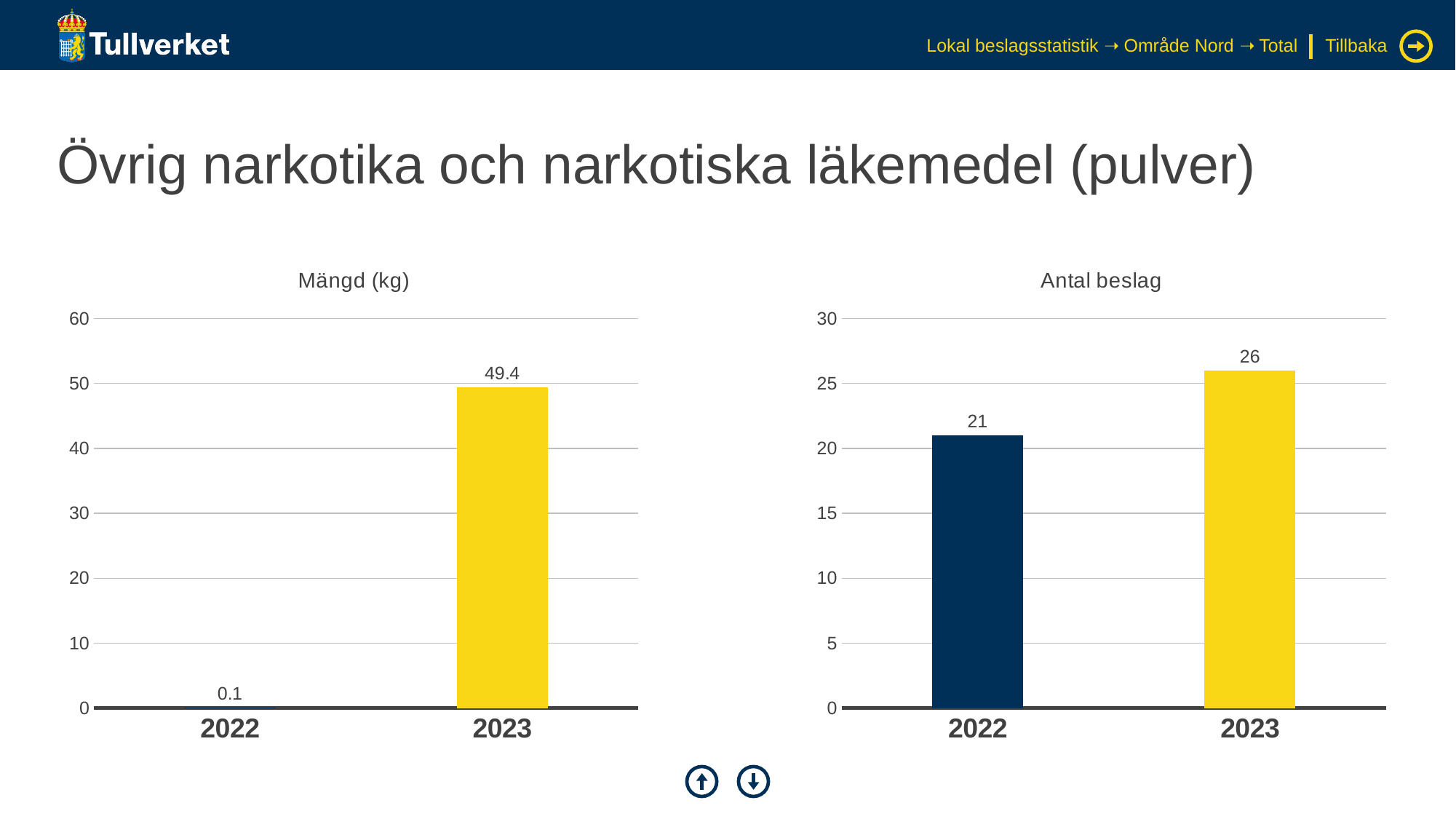
In the "Antal beslag" chart, what is the value for 2023? 26 In the "Mängd (kg)" chart, which year has the lowest value? 2022 How many categories are shown on the x axis of the "Antal beslag" chart? 2 In the "Mängd (kg)" chart, what is the value for 2022? 0.1 In the "Antal beslag" chart, do the values rise or fall from 2022 to 2023? rise In the "Mängd (kg)" chart, what is the difference between the 2023 and 2022 values? 49.3 In the "Antal beslag" chart, what is the difference between the 2023 and 2022 values? 5 In the "Mängd (kg)" chart, is the value for 2023 greater or less than 40? greater In the "Antal beslag" chart, which year has the highest value? 2023 What kind of chart is the "Mängd (kg)" chart? bar chart In the "Antal beslag" chart, what is the value for 2022? 21 In the "Mängd (kg)" chart, what is the value for 2023? 49.4